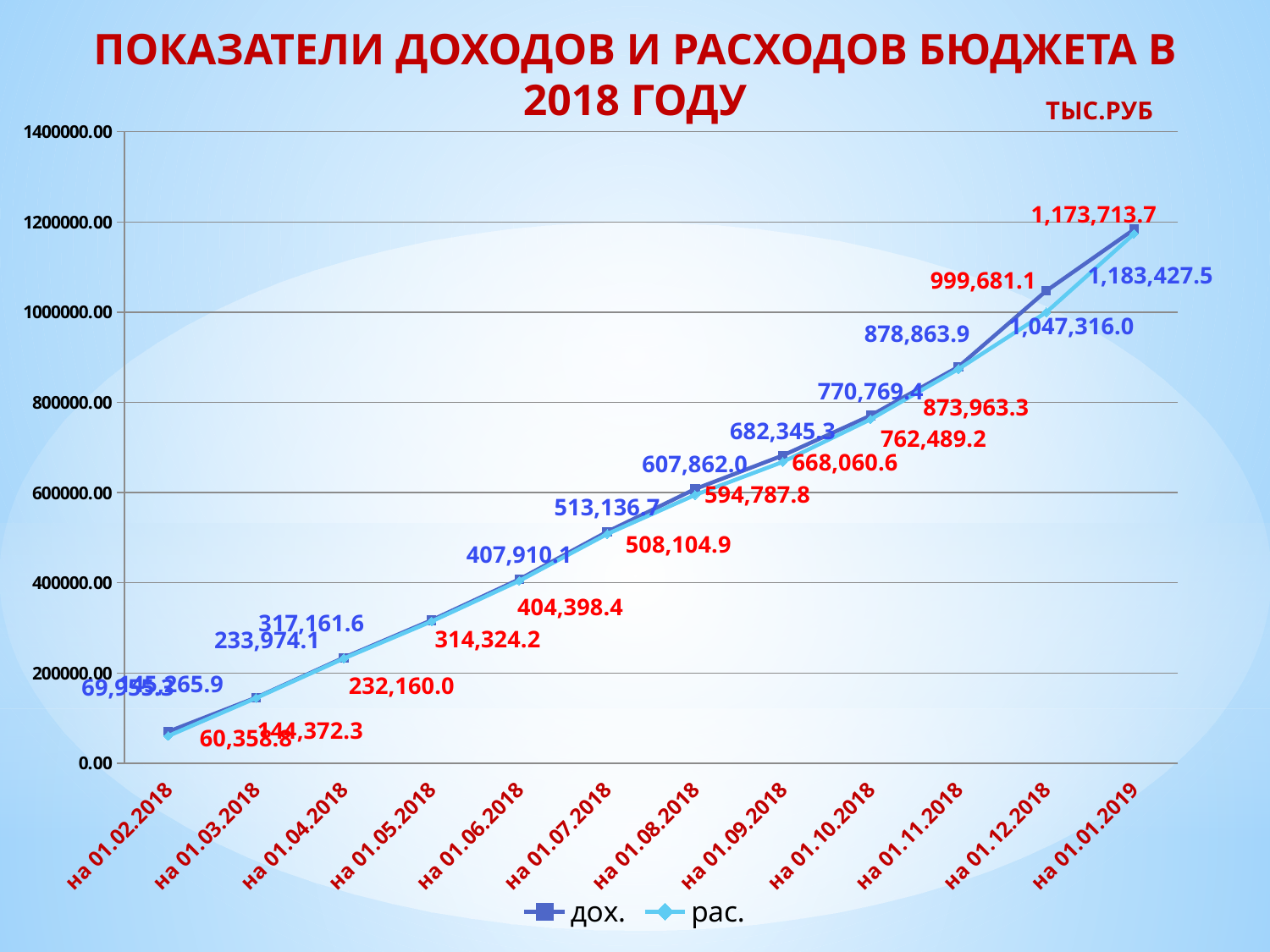
What kind of chart is shown on the slide? line chart How many series does the legend list? 2 What is the value of дох. на 01.01.2019? 1,183,427.5 What is the value of рас. на 01.07.2018? 508,104.9 What is the value of рас. на 01.05.2018? 314,324.2 Do the values of the рас. series rise or fall from 01.02.2018 to 01.01.2019? rise How many dates are plotted along the x axis? 12 What is the value of рас. на 01.12.2018? 999,681.1 На 01.12.2018, which is larger: дох. or рас.? дох. At which date does the дох. series reach its highest value? на 01.01.2019 What is the value of дох. на 01.07.2018? 513,136.7 What is the difference between дох. and рас. на 01.12.2018? 47,634.9